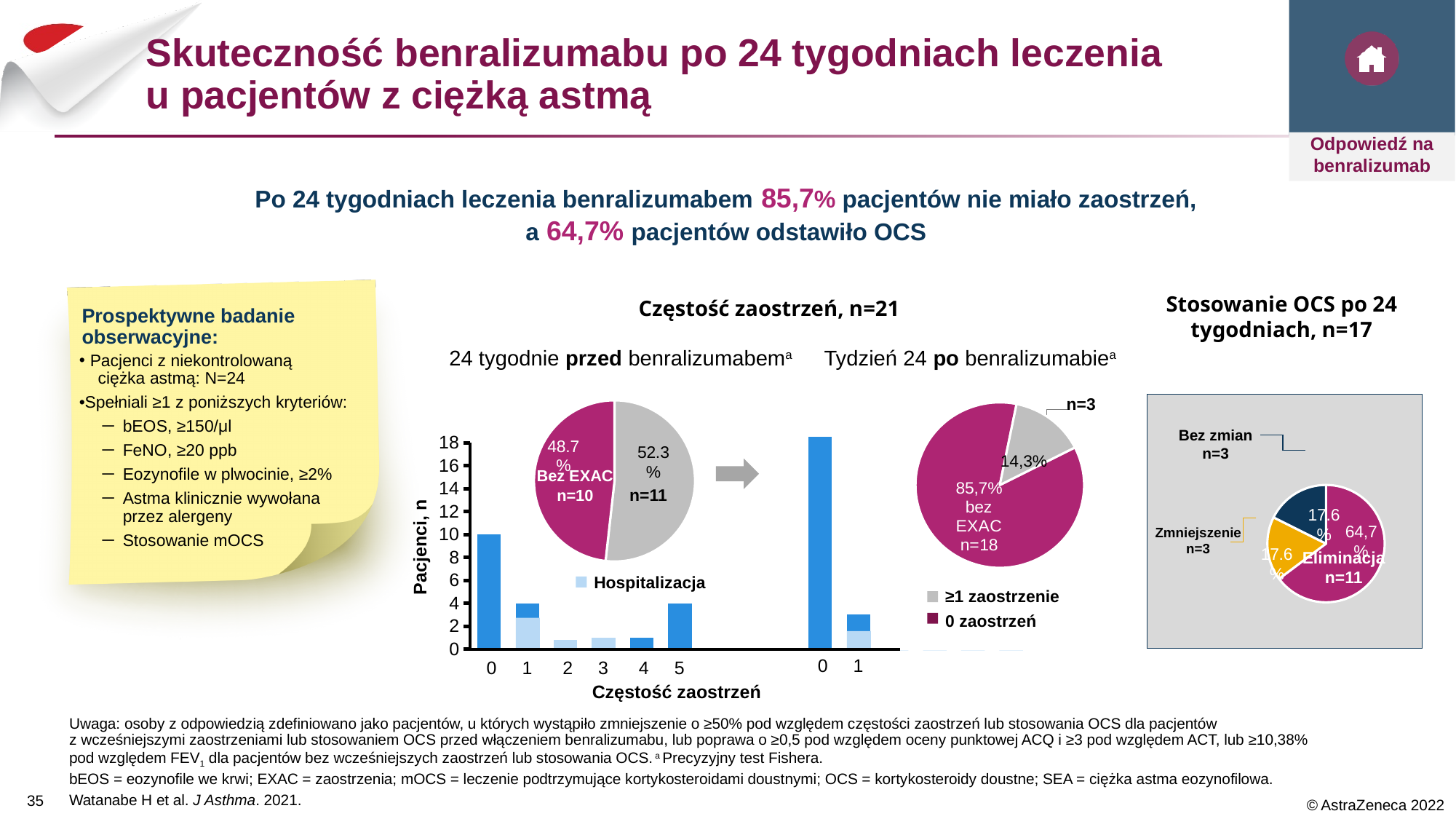
In the pie chart 'Stosowanie OCS po 24 tygodniach, n=17', which category has the largest share? Eliminacja In the bar chart 'Częstość zaostrzeń' for week 24 after benralizumab, is the value for 0 exacerbations greater or less than 16? greater In the pie chart 'Tydzień 24 po benralizumabie', what is the n value for the '≥1 zaostrzenie' slice? n=3 In the pie chart '24 tygodnie przed benralizumabem', what is the n value for the grey slice? n=11 In the pie chart 'Tydzień 24 po benralizumabie', which slice is larger: '0 zaostrzeń' or '≥1 zaostrzenie'? 0 zaostrzeń In the pie chart '24 tygodnie przed benralizumabem', what percentage is shown for the 'Bez EXAC' slice? 48.7% In the pie chart 'Tydzień 24 po benralizumabie', what percentage of patients had no exacerbations (bez EXAC)? 85,7% What kind of chart is used to show 'Częstość zaostrzeń' by number of exacerbations (Pacjenci, n)? bar chart In the bar chart 'Częstość zaostrzeń' for the period before benralizumab, how many patients had 0 exacerbations? 10 How many slices does the pie chart 'Stosowanie OCS po 24 tygodniach, n=17' have? 3 In the bar chart 'Częstość zaostrzeń' for the period before benralizumab, is the value for 5 exacerbations greater or less than 2? greater In the pie chart 'Stosowanie OCS po 24 tygodniach, n=17', what percentage is shown for 'Eliminacja'? 64,7%